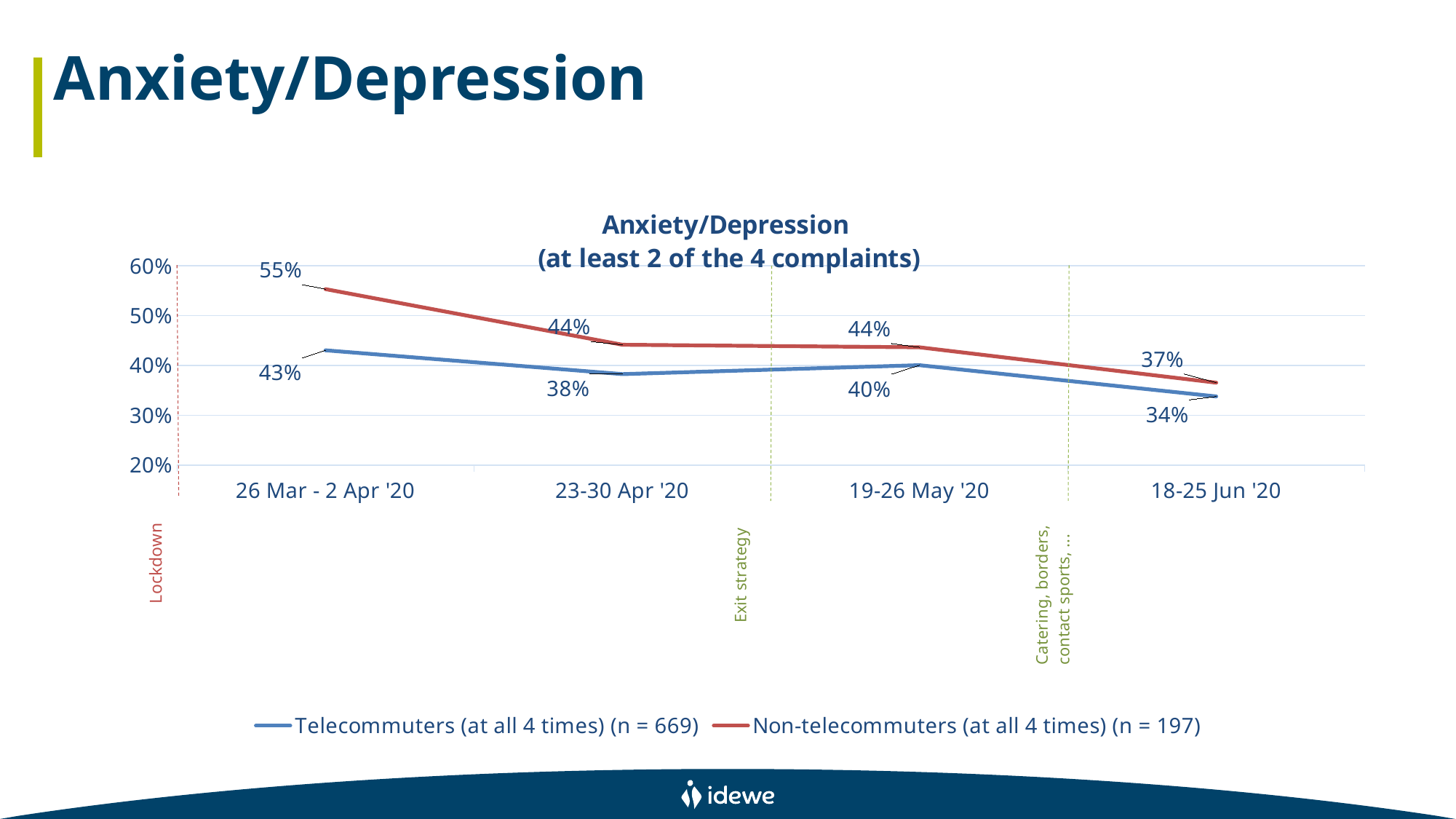
How many series does the legend list? 2 In which period is the Non-telecommuters value highest? 26 Mar - 2 Apr '20 What is the value for Non-telecommuters in the 19-26 May '20 period? 44% How many time periods are shown on the x axis? 4 In which period is the Telecommuters value lowest? 18-25 Jun '20 What is the value for Telecommuters in the 23-30 Apr '20 period? 38% What kind of chart is shown? Line chart What is the difference between Non-telecommuters and Telecommuters in the 26 Mar - 2 Apr '20 period? 12% What is the value for Telecommuters in the 18-25 Jun '20 period? 34% Which series has the higher value in the 18-25 Jun '20 period? Non-telecommuters (at all 4 times) (n = 197) What is the value for Non-telecommuters in the 26 Mar - 2 Apr '20 period? 55% Does the Non-telecommuters line rise or fall from the first period to the last? Fall